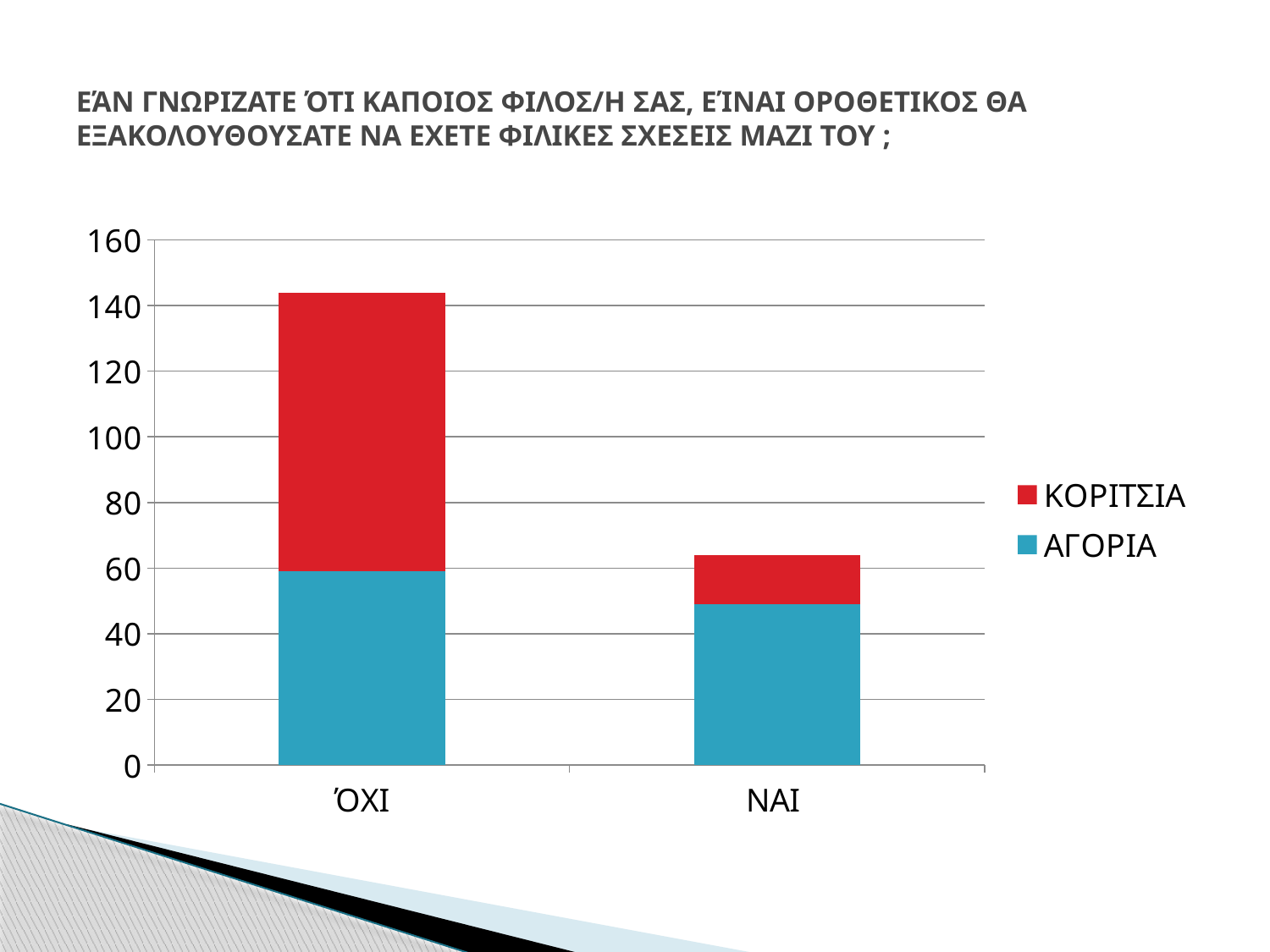
Within the ΝΑΙ bar, which series has the larger segment, ΚΟΡΙΤΣΙΑ or ΑΓΟΡΙΑ? ΑΓΟΡΙΑ What kind of chart is shown on the slide? Stacked bar chart Is the total height of the ΌΧΙ bar greater or less than 120? greater What colour represents the ΚΟΡΙΤΣΙΑ series in the legend? Red Which is larger: the ΑΓΟΡΙΑ value for ΌΧΙ or the ΑΓΟΡΙΑ value for ΝΑΙ? ΌΧΙ Which category has the tallest stacked bar? ΌΧΙ How many series does the legend list? 2 Is the ΑΓΟΡΙΑ value for ΌΧΙ greater or less than 40? greater How many categories are shown on the x axis? 2 Which category has the shortest stacked bar? ΝΑΙ Is the total height of the ΝΑΙ bar greater or less than 80? less